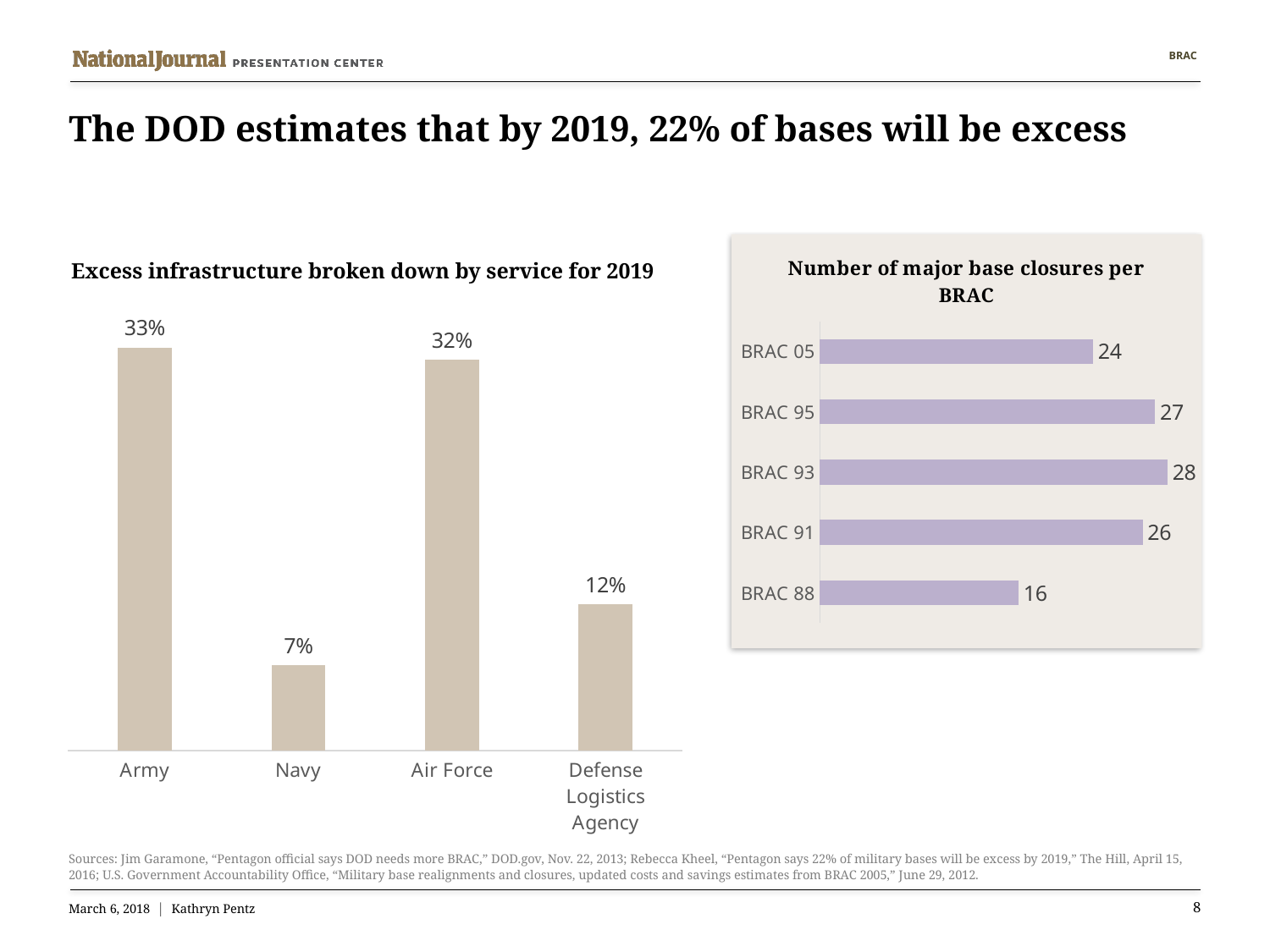
In the 'Excess infrastructure broken down by service for 2019' chart, which service has the lowest value? Navy In the 'Number of major base closures per BRAC' chart, which BRAC round has the highest number of closures? BRAC 93 In the 'Number of major base closures per BRAC' chart, which is larger, BRAC 95 or BRAC 91? BRAC 95 In the 'Number of major base closures per BRAC' chart, what is the difference between BRAC 93 and BRAC 88? 12 In the 'Excess infrastructure broken down by service for 2019' chart, how many services are shown? 4 In the 'Number of major base closures per BRAC' chart, what is the value for BRAC 88? 16 What kind of chart is 'Excess infrastructure broken down by service for 2019'? Bar chart In the 'Excess infrastructure broken down by service for 2019' chart, what is the value for Navy? 7% In the 'Number of major base closures per BRAC' chart, how many BRAC rounds are shown? 5 In the 'Excess infrastructure broken down by service for 2019' chart, what is the value for Army? 33% In the 'Excess infrastructure broken down by service for 2019' chart, what is the difference between Air Force and Defense Logistics Agency? 20% In the 'Number of major base closures per BRAC' chart, what is the value for BRAC 05? 24